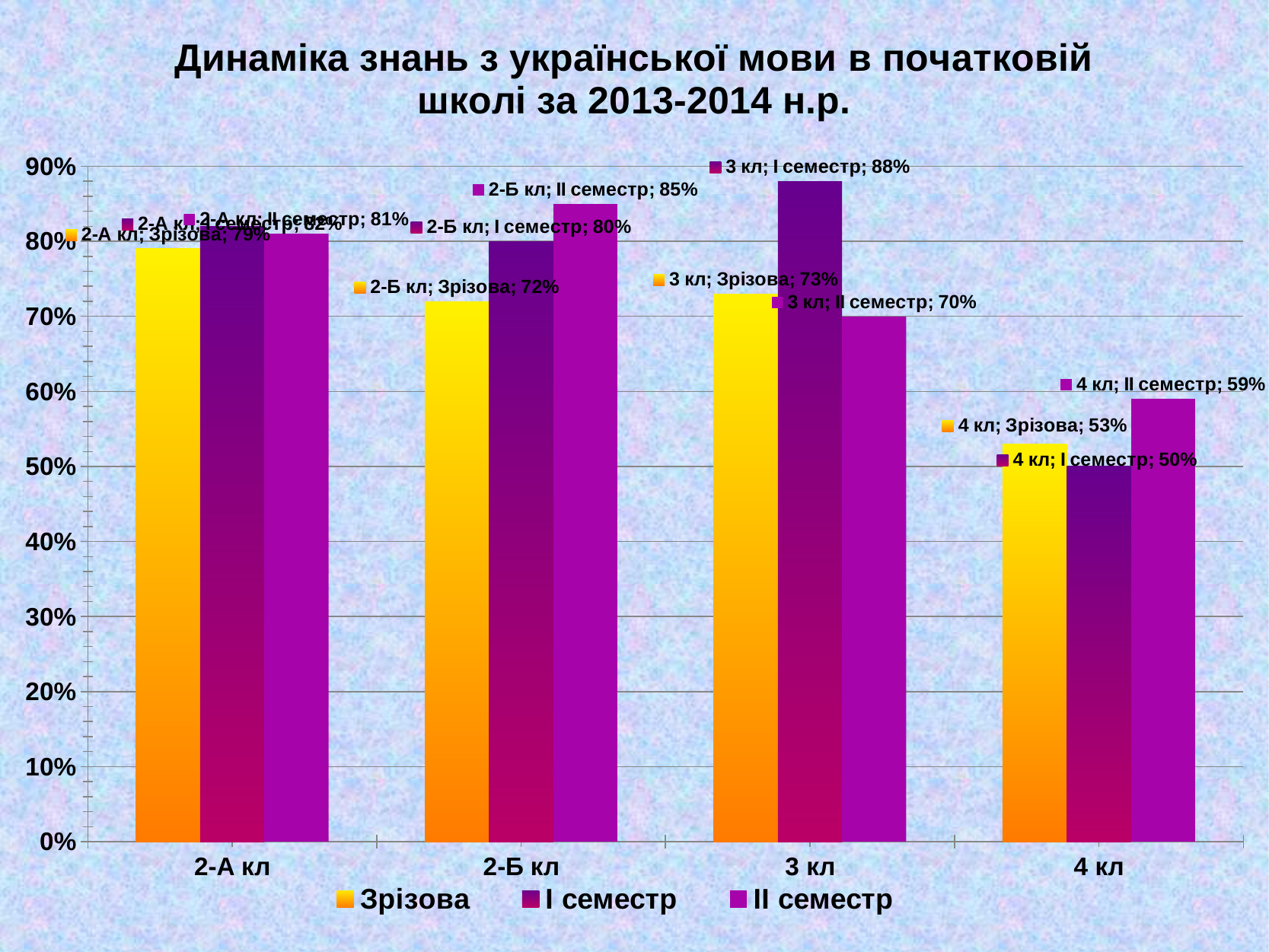
What is the value for ІІ семестр in 4 кл? 59% What is the difference between the ІІ семестр and Зрізова values in 2-Б кл? 13% Which class has the highest І семестр value? 3 кл Which class has the lowest І семестр value? 4 кл What is the value for ІІ семестр in 2-Б кл? 85% How many classes (categories) are shown on the x axis? 4 What is the value for Зрізова in 2-Б кл? 72% Which is larger in 3 кл: the Зрізова value or the ІІ семестр value? Зрізова How many series does the legend list? 3 What is the value for І семестр in 3 кл? 88% What kind of chart is shown on the slide? bar chart Do the Зрізова values rise or fall from 3 кл to 4 кл? fall